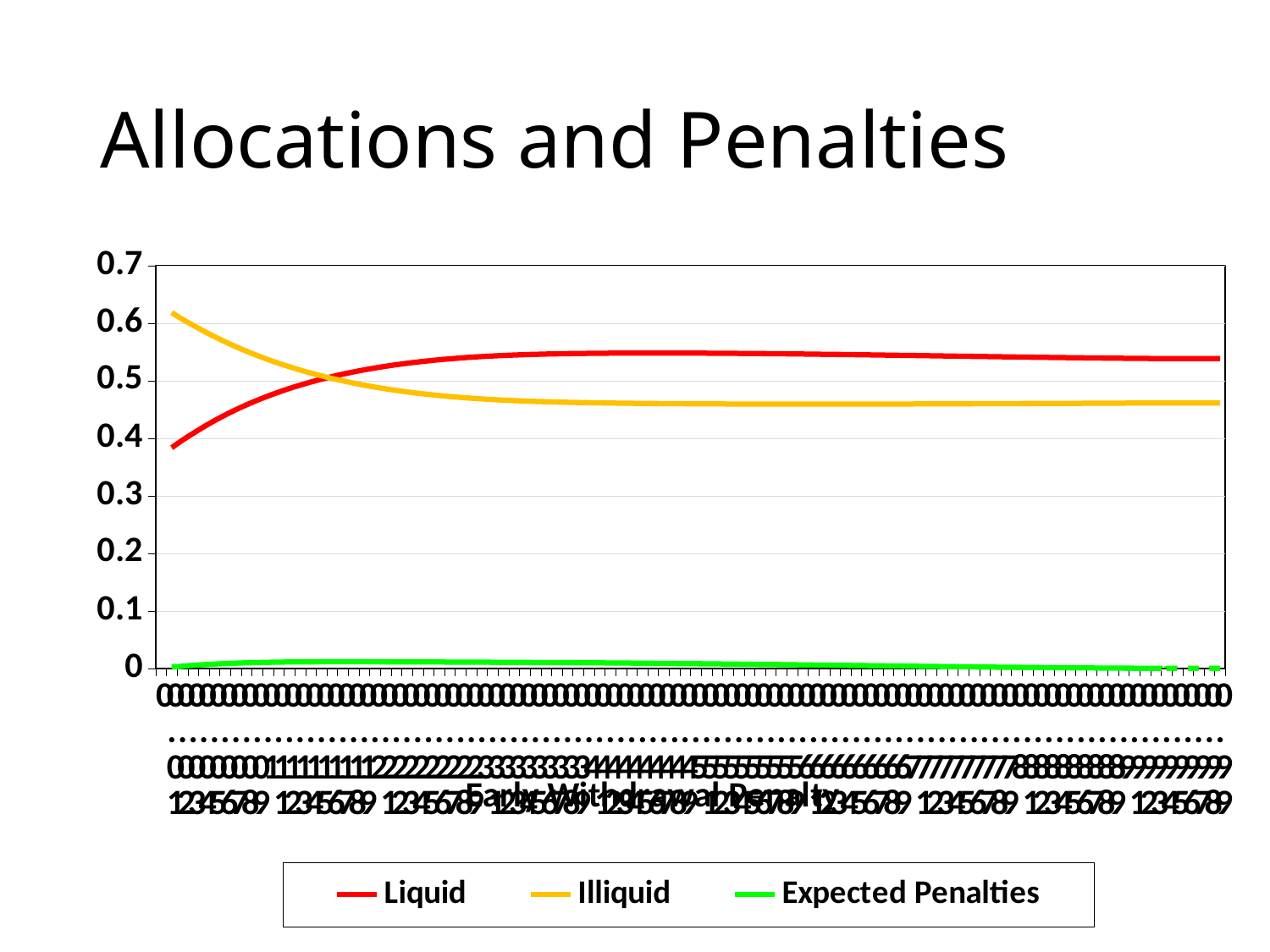
Is the value of the Expected Penalties series ever greater or less than 0.1? less Is the value of the Liquid series at the right end of the chart greater or less than 0.5? greater At the right end of the chart, which series is higher, Liquid or Illiquid? Liquid Does the Illiquid series rise or fall along the x axis at the left side of the chart? Fall At the left end of the chart, which series is higher, Liquid or Illiquid? Illiquid Is the starting value of the Illiquid series greater or less than 0.6? greater Does the Liquid series rise or fall along the x axis at the left side of the chart? Rise How many series does the legend list? 3 What is the title of the slide containing the chart? Allocations and Penalties Which series stays lowest across the whole chart? Expected Penalties Which series is drawn in green? Expected Penalties What kind of chart is shown on the slide? Line chart